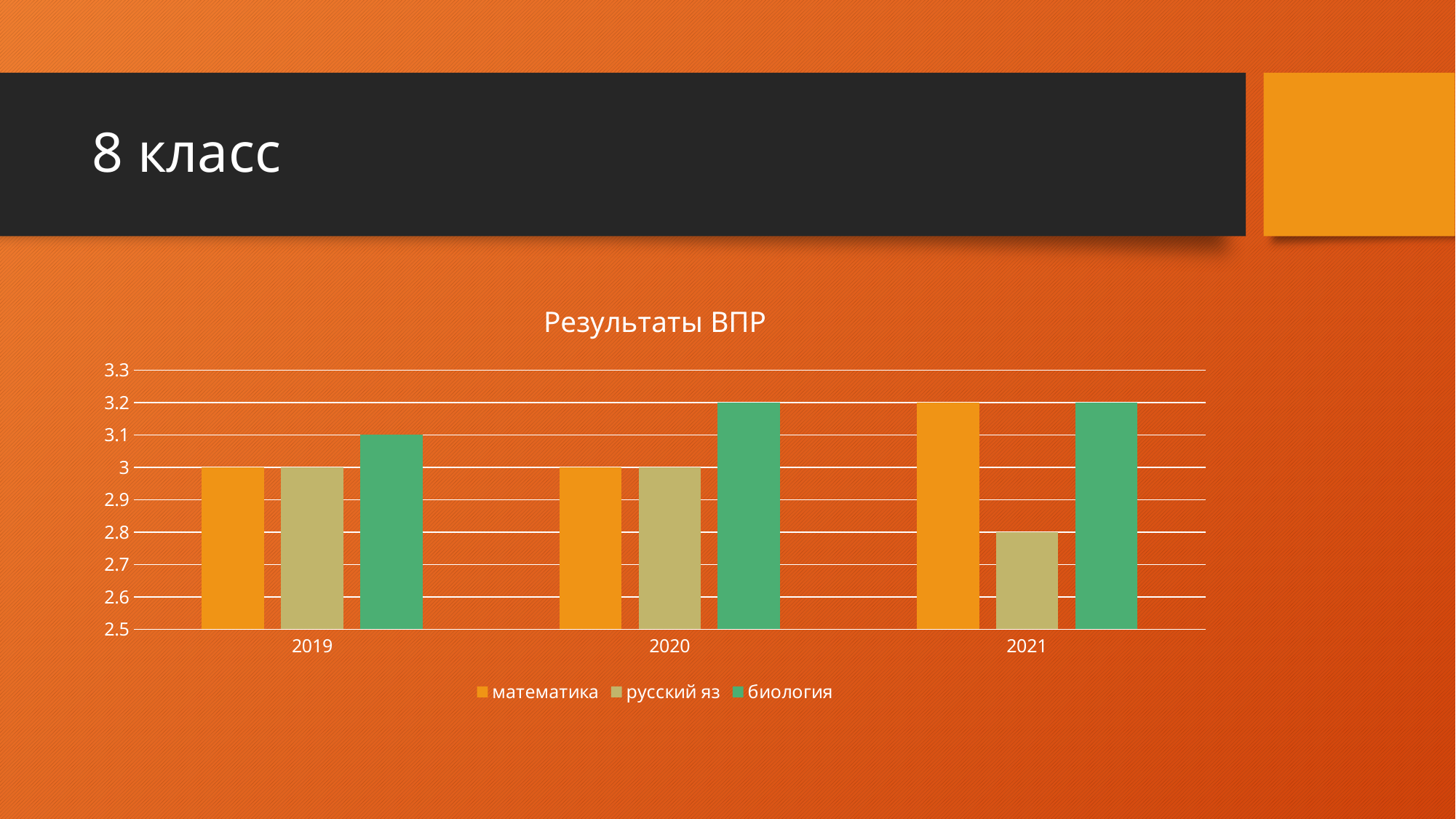
What is the difference between биология and русский яз in 2021? 0.4 What kind of chart is shown on the slide? bar chart How many series does the legend list? 3 Does the value for математика rise or fall from 2020 to 2021? rise Which is larger in 2019: the value for математика or the value for биология? биология What is the value for биология in 2019? 3.1 Which subject has the highest value in 2020? биология What is the value for математика in 2021? 3.2 What is the value for русский яз in 2021? 2.8 What is the title of the chart? Результаты ВПР How many years are shown on the x axis? 3 In which year is the value for русский яз lowest? 2021